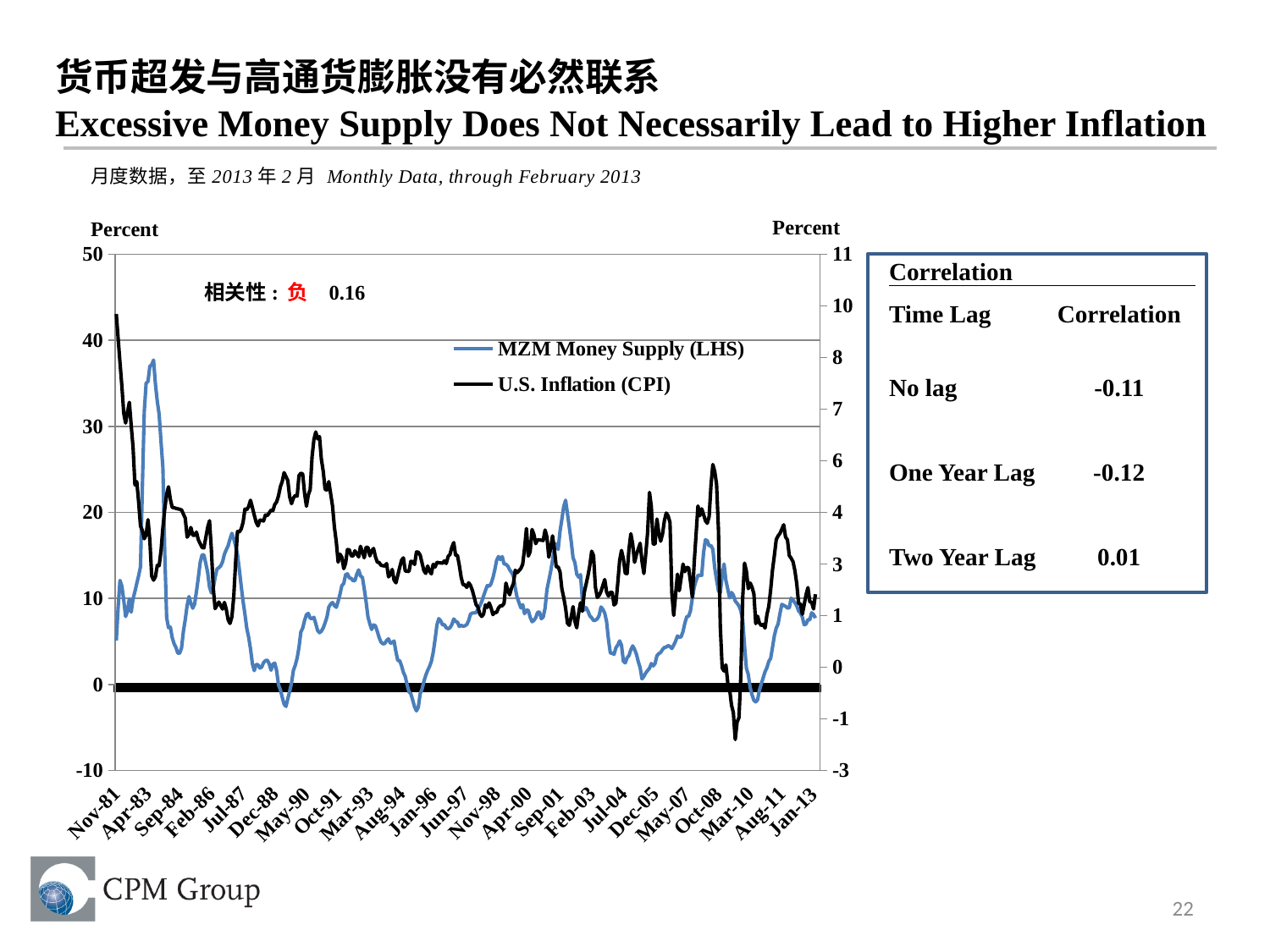
How many series does the chart legend list? 2 What is the correlation with a two year lag shown in the table? 0.01 What kind of chart is shown on the slide? Line chart Is the peak value of MZM Money Supply around Apr-83 greater or less than 30 on the left axis? greater Which series is plotted on the left-hand axis according to the legend? MZM Money Supply (LHS) What is the correlation with no lag shown in the table? -0.11 Does the U.S. Inflation (CPI) line rise or fall overall between Nov-81 and Feb-86? Fall What is the correlation with a one year lag shown in the table? -0.12 Is the lowest U.S. Inflation (CPI) value, reached between Oct-08 and Mar-10, greater or less than 0 on the right axis? less Is the U.S. Inflation (CPI) value at Nov-81 greater or less than 8 on the right axis? greater Does the MZM Money Supply line rise or fall between Nov-81 and Apr-83? Rise What colour is the U.S. Inflation (CPI) line? Black